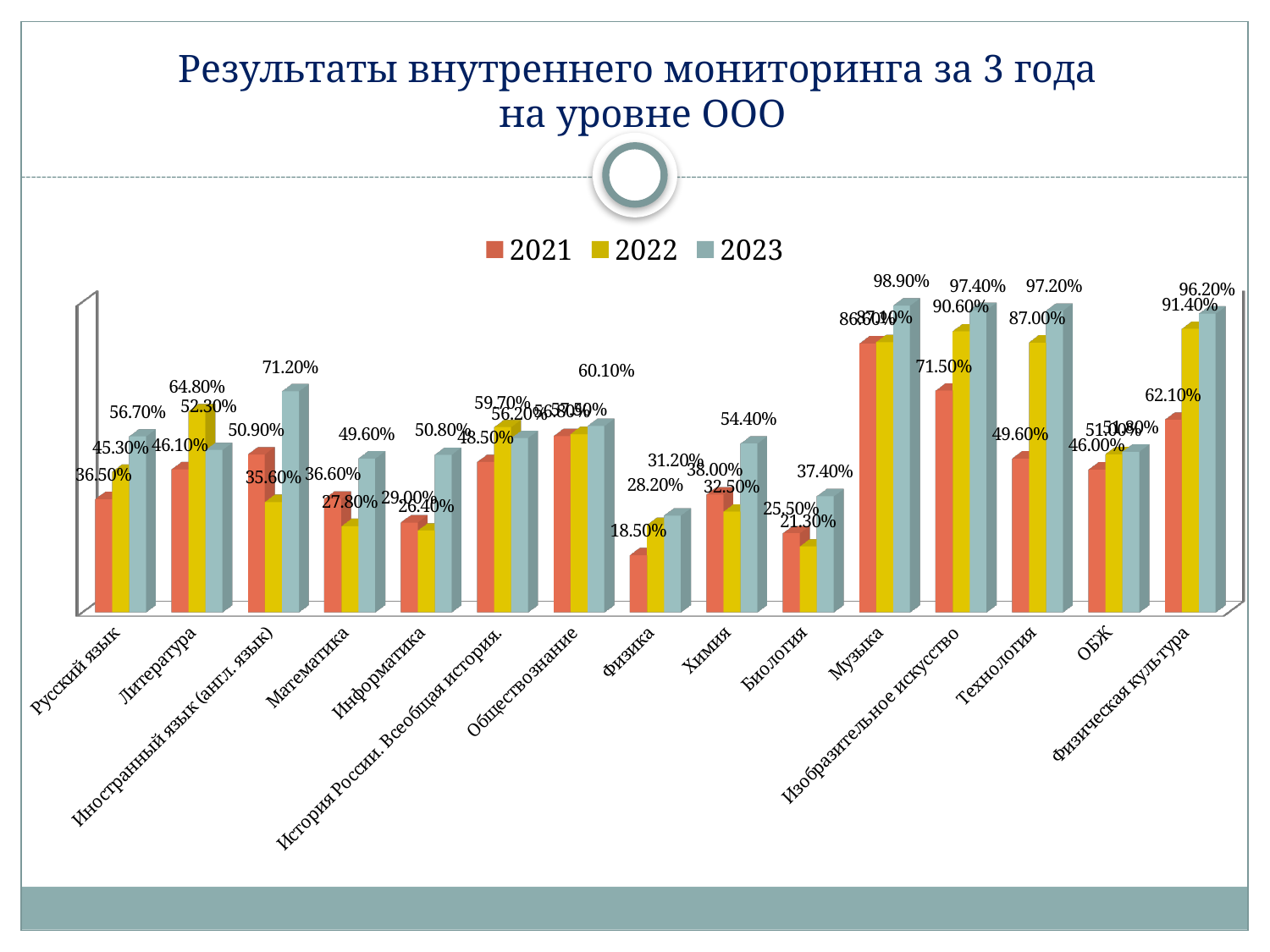
What is the value for Технология in 2022? 87.00% What is the difference between the 2023 and 2021 values for Физическая культура? 34.10% For Литература, which year has the larger value, 2022 or 2023? 2022 What kind of chart is shown on the slide? Bar chart How many series does the legend list? 3 Which subject has the highest value in 2023? Музыка What is the value for Физика in 2021? 18.50% What is the value for Иностранный язык (англ. язык) in 2023? 71.20% What is the value for Химия in 2023? 54.40% Do the values for Русский язык rise or fall from 2021 to 2023? Rise Which subject has the lowest value in 2021? Физика How many subjects are shown on the x axis? 15